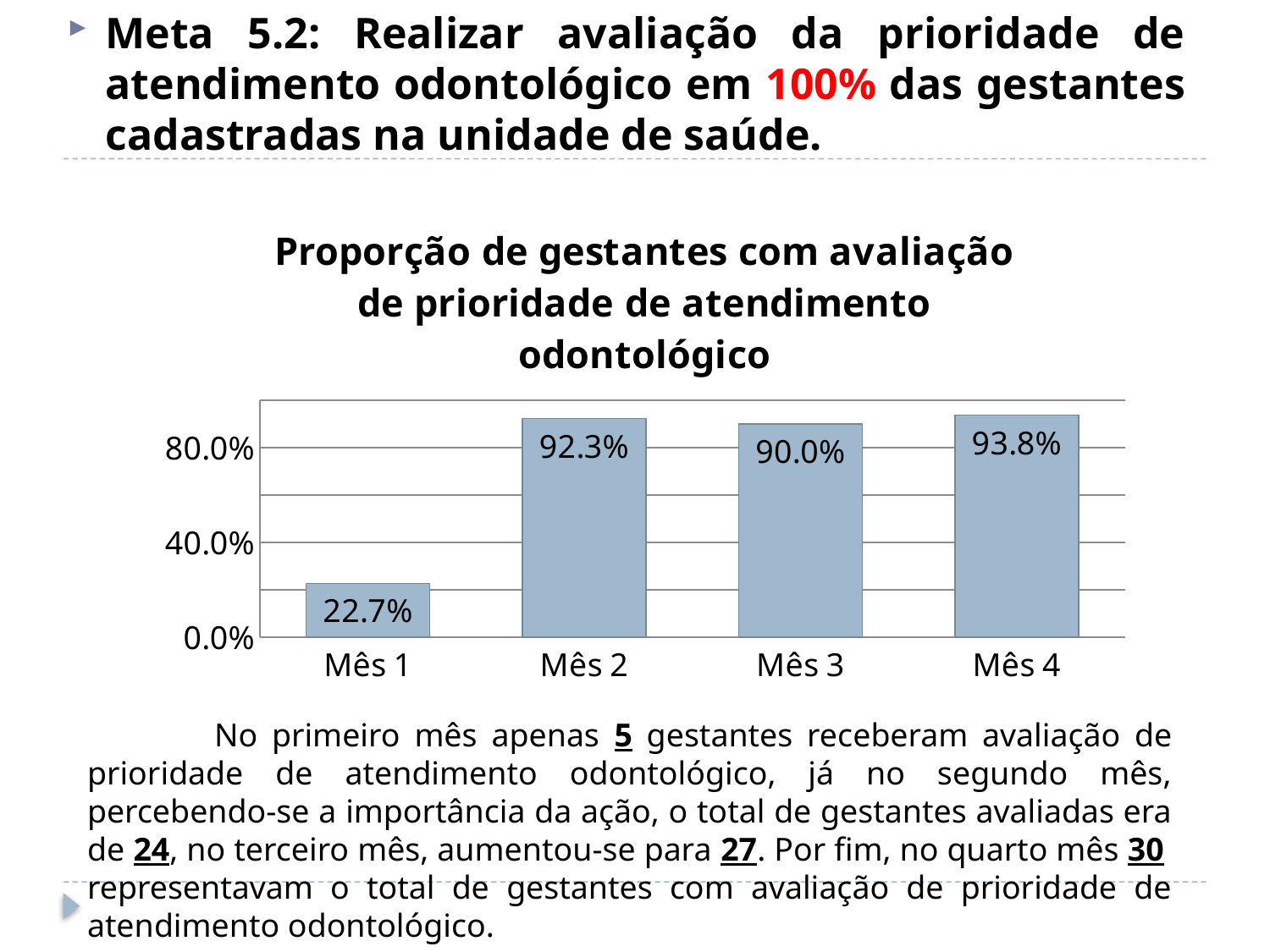
What is the value for Mês 1? 22.7% Which month has the lowest value? Mês 1 What is the value for Mês 4? 93.8% How many months are shown on the x axis? 4 Is the value for Mês 1 greater or less than 40.0%? less What is the difference between the values for Mês 4 and Mês 3? 3.8% Which month has the highest value? Mês 4 What is the value for Mês 2? 92.3% What is the difference between the values for Mês 2 and Mês 1? 69.6% What is the value for Mês 3? 90.0% Which is larger, the value for Mês 2 or the value for Mês 3? Mês 2 What kind of chart is shown on the slide? bar chart